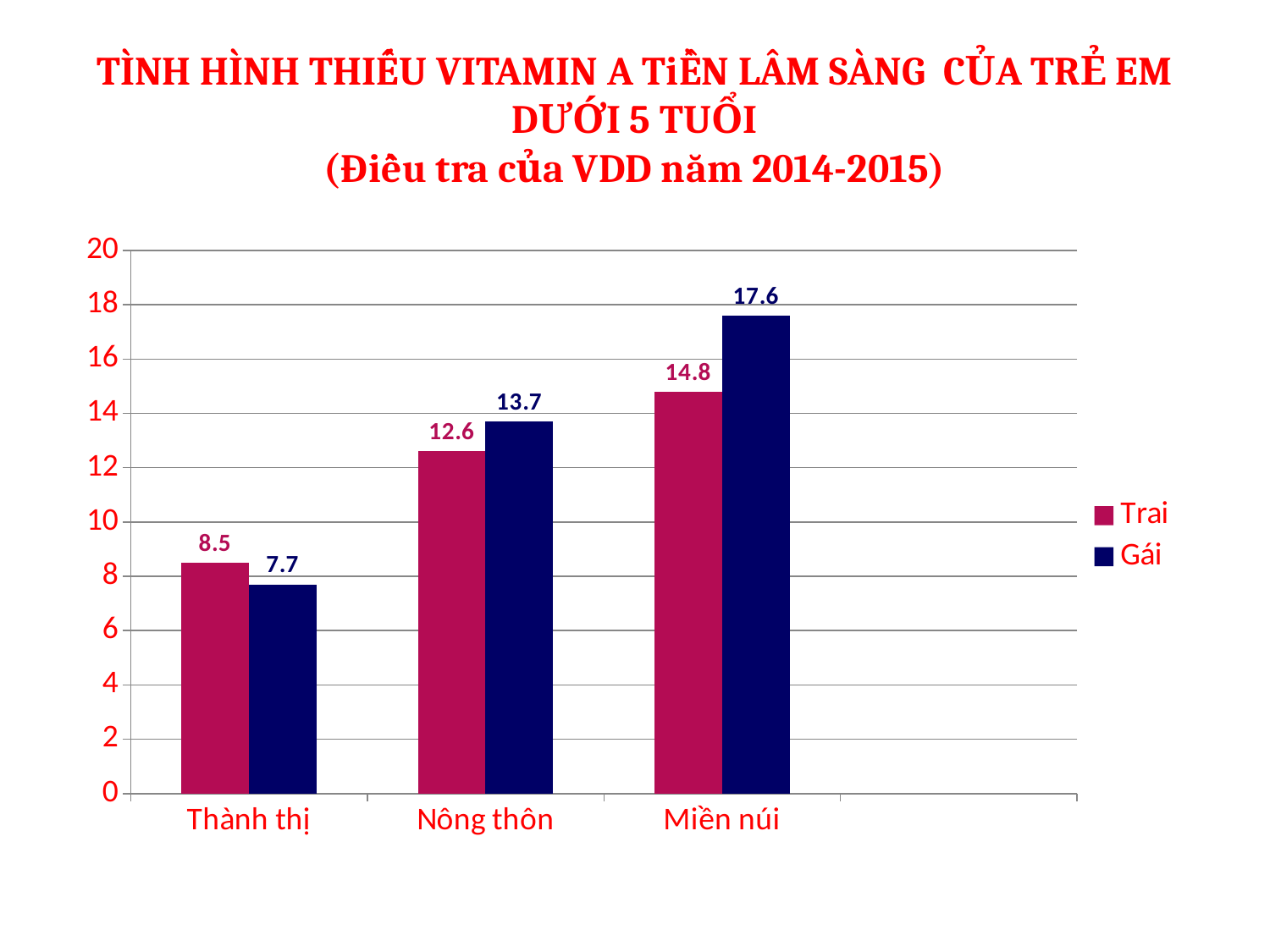
What is the value for Gái in Nông thôn? 13.7 Do the Trai values rise or fall from Thành thị to Miền núi? Rise Which is larger in Thành thị, the Trai value or the Gái value? Trai Which category has the lowest value for Trai? Thành thị What is the value for Trai in Thành thị? 8.5 How many categories are shown on the x axis? 3 How many series does the legend list? 2 Is the value for Trai in Nông thôn greater or less than 12? greater Which category has the highest value for Gái? Miền núi What is the difference between the Gái and Trai values in Miền núi? 2.8 What is the value for Gái in Miền núi? 17.6 What kind of chart is shown on the slide? Bar chart